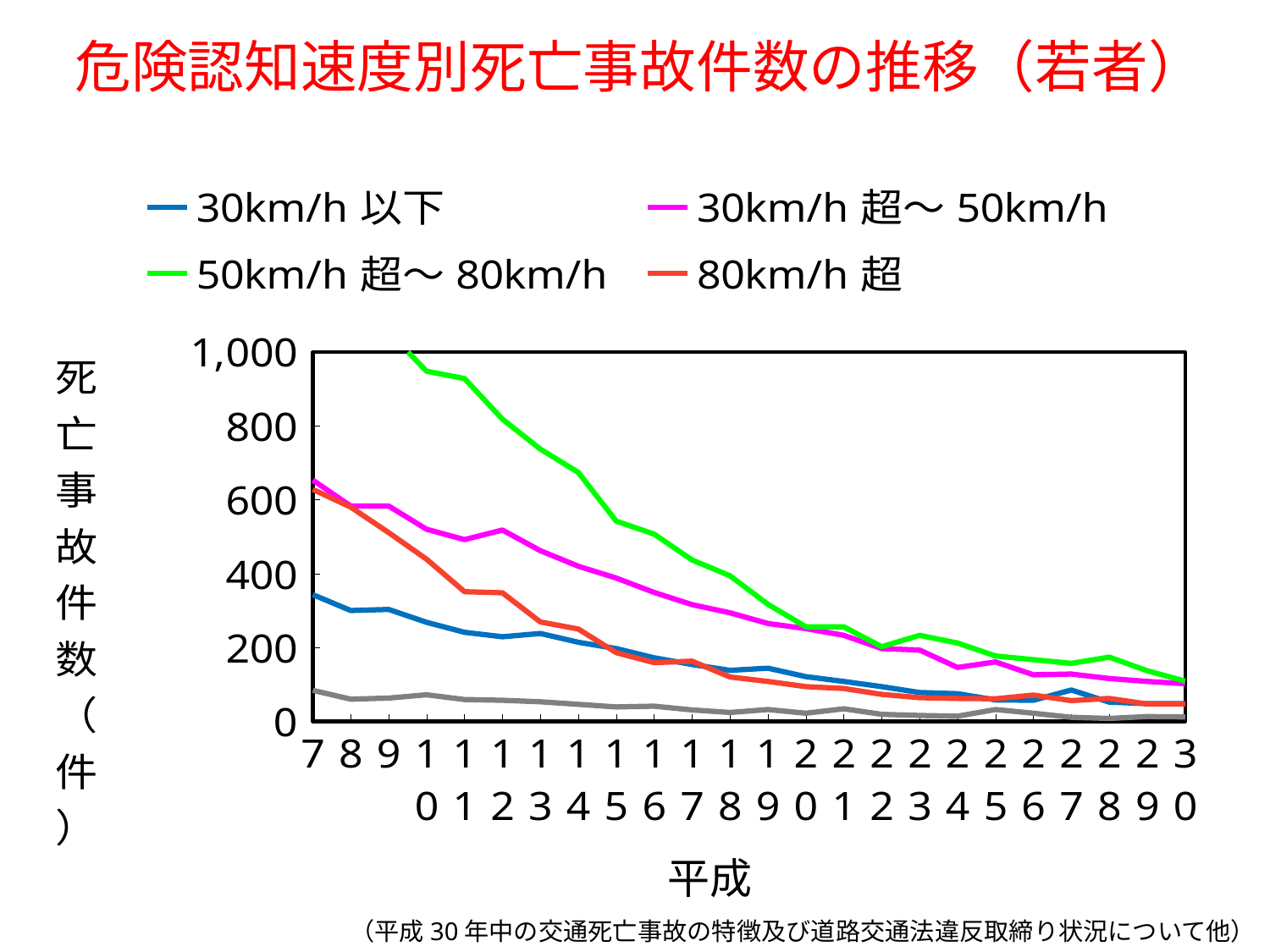
Is the value for 50km/h 超～ 80km/h at 平成10 greater or less than 800? greater Does the 50km/h 超～ 80km/h line rise or fall from 平成7 to 平成30? fall What is the title of the chart? 危険認知速度別死亡事故件数の推移（若者） What is the label of the x axis? 平成 Is the value for 80km/h 超 at 平成30 greater or less than 200? less Which series has the highest value at 平成15? 50km/h 超～ 80km/h Is the value for 30km/h 以下 at 平成7 greater or less than 400? less How many years (x-axis points) are plotted, from 平成7 to 平成30? 24 At 平成7, which is larger: 30km/h 超～ 50km/h or 30km/h 以下? 30km/h 超～ 50km/h How many series does the legend list? 4 What kind of chart is shown on the slide? line chart